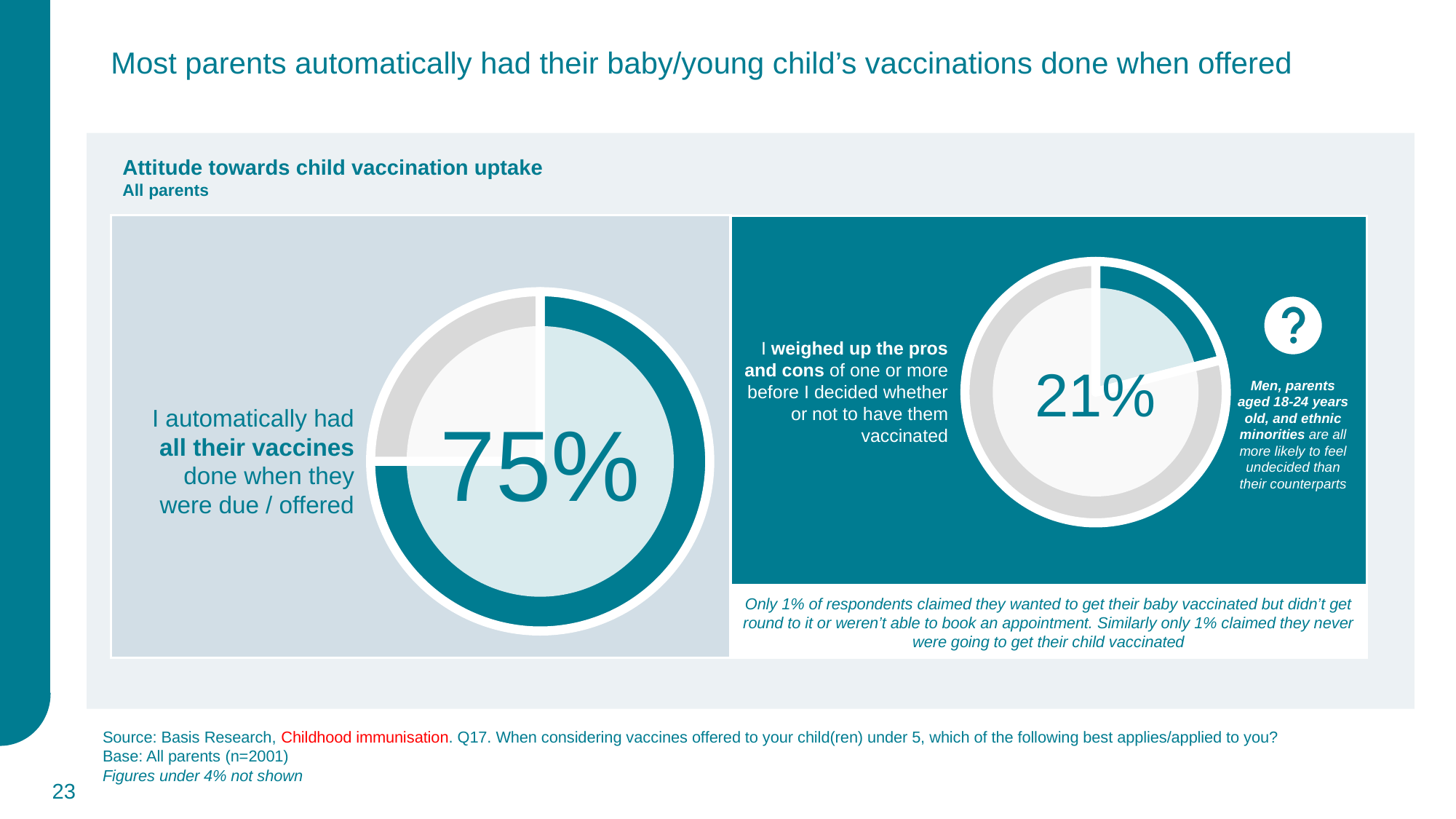
What kind of chart is used on the left to show the 75% figure? Pie (donut) chart On the right chart, is the value for parents who weighed up the pros and cons greater or less than 25%? less What is the difference in percentage points between the 75% on the left chart and the 21% on the right chart? 54 percentage points On the left chart, what percentage of parents said they automatically had all their vaccines done when they were due / offered? 75% On the right chart, what percentage of parents said they weighed up the pros and cons of one or more before deciding whether or not to have them vaccinated? 21% What is the base (sample size) shown for the charts on the slide? All parents (n=2001) On the left chart, is the value for parents who automatically had all their vaccines done greater or less than 50%? greater What is the title of the chart panel on the slide? Attitude towards child vaccination uptake Which is larger: the share of parents who automatically had all their vaccines done (left chart) or the share who weighed up the pros and cons (right chart)? Automatically had all their vaccines done (75%) On the left chart, what share of the whole pie does the highlighted segment represent? 75% How many charts are shown on the slide? 2